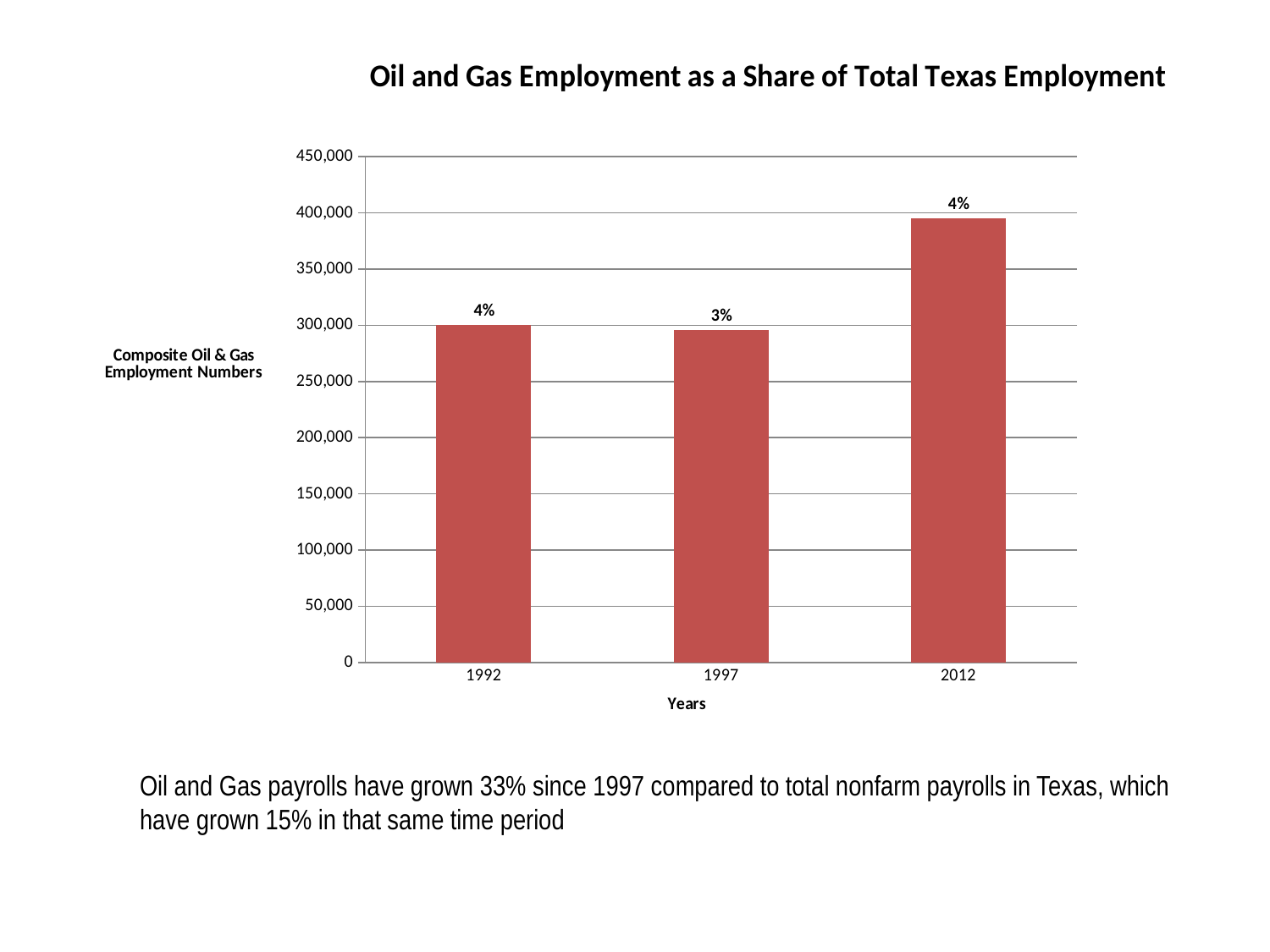
What data label is printed above the bar for 2012? 4% Is the value for 2012 greater or less than 400,000? less Which is larger, the value for 1992 or the value for 2012? 2012 How many years are shown on the x axis of the chart? 3 Is the value for 2012 greater or less than 350,000? greater What data label is printed above the bar for 1997? 3% Is the value for 1997 greater or less than 250,000? greater What is the title of the chart? Oil and Gas Employment as a Share of Total Texas Employment What data label is printed above the bar for 1992? 4% Which year has the highest composite oil and gas employment number? 2012 Does the value rise or fall from 1997 to 2012? rise What kind of chart is shown on the slide? bar chart